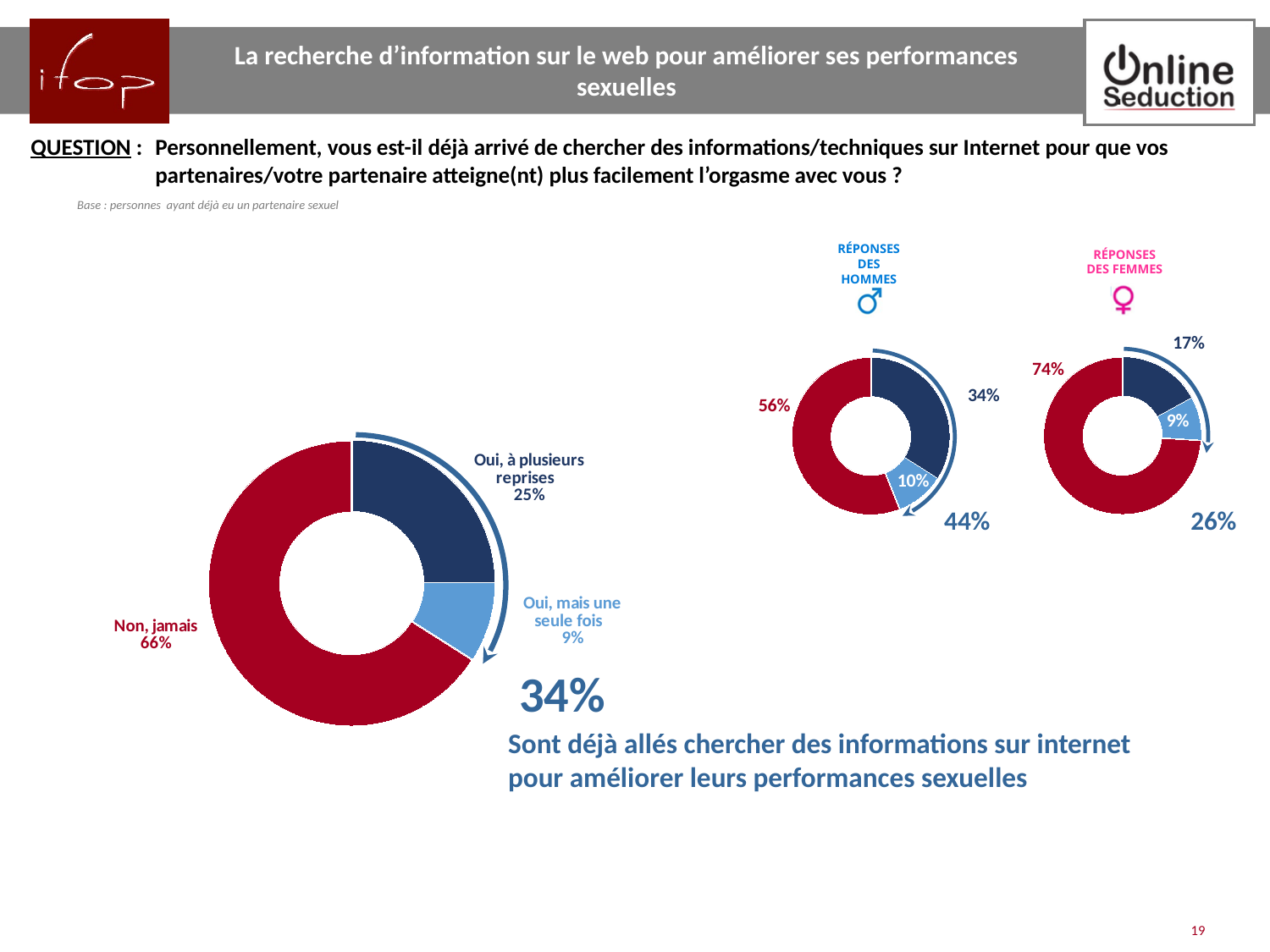
In the large donut chart on the left, what percentage answered "Oui, mais une seule fois"? 9% In the "Réponses des femmes" donut chart, what percentage is shown for the light blue segment ("Oui, mais une seule fois")? 9% In the "Réponses des femmes" donut chart, what percentage answered "Non, jamais" (the red segment)? 74% What is the difference between the "Non, jamais" share for women (74%) and for men (56%)? 18 points In the large donut chart on the left, what percentage answered "Non, jamais"? 66% In the large donut chart on the left, what percentage answered "Oui, à plusieurs reprises"? 25% In the large donut chart on the left, which response has the largest share? Non, jamais What type of chart is used to show the responses on this slide? Donut (pie) chart Which group has a higher combined "Oui" share, men (44%) or women (26%)? Men In the large donut chart on the left, which response has the smallest share? Oui, mais une seule fois In the "Réponses des hommes" donut chart, what percentage is shown for the dark blue segment ("Oui, à plusieurs reprises")? 34% In the "Réponses des hommes" donut chart, what percentage answered "Non, jamais" (the red segment)? 56%